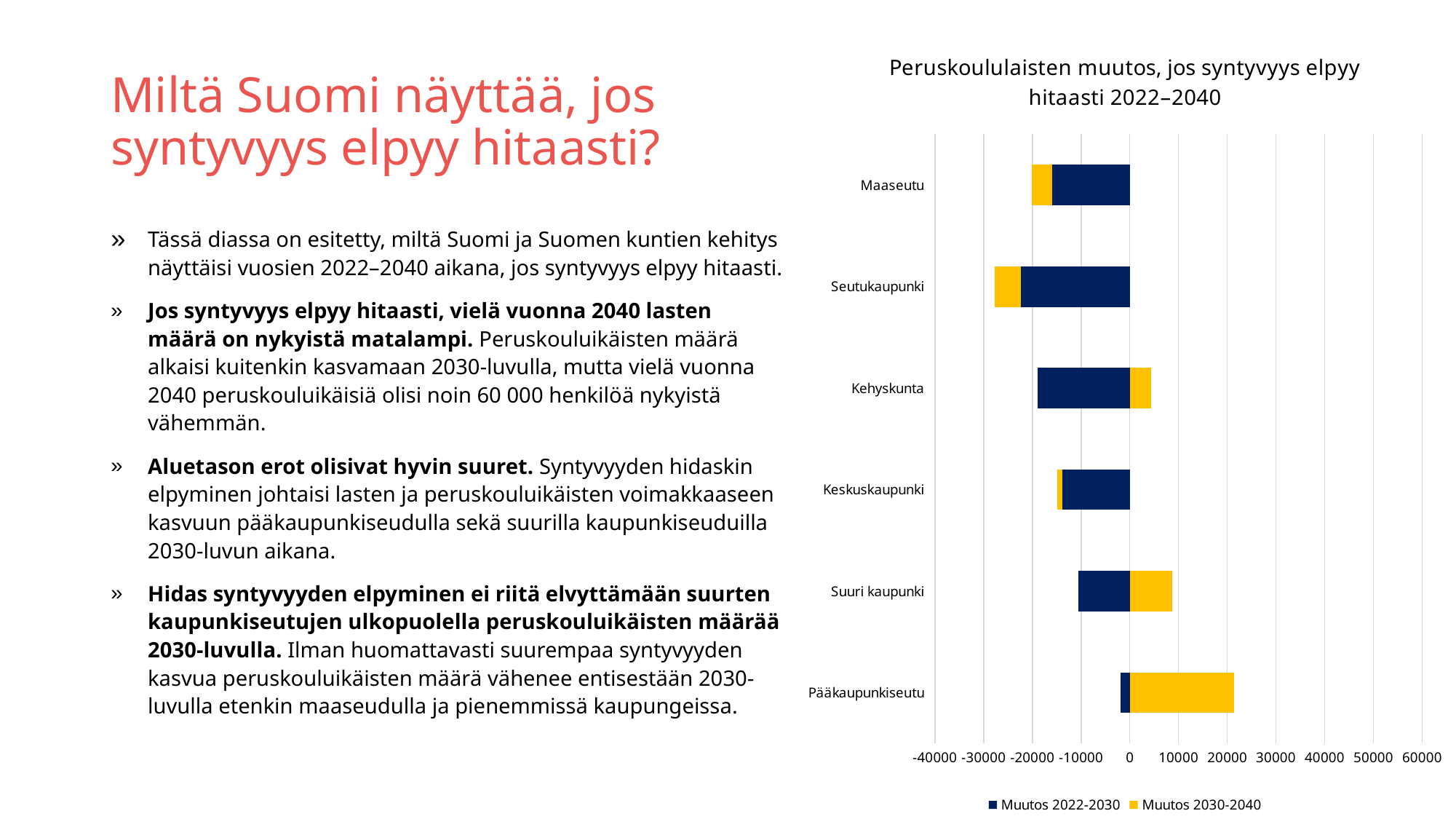
Which category has the largest positive value for Muutos 2030-2040? Pääkaupunkiseutu Is the value for Muutos 2030-2040 for Pääkaupunkiseutu greater or less than 10000? greater Is the value for Muutos 2022-2030 for Maaseutu greater or less than -10000? less What kind of chart is shown on the slide? Bar chart Which has the larger Muutos 2030-2040 value, Pääkaupunkiseutu or Suuri kaupunki? Pääkaupunkiseutu How many categories (area types) are shown on the chart? 6 What is the title of the chart? Peruskoululaisten muutos, jos syntyvyys elpyy hitaasti 2022–2040 Which category has the most negative value for Muutos 2022-2030? Seutukaupunki Which category has the smallest decline (value closest to zero) for Muutos 2022-2030? Pääkaupunkiseutu Is the value for Muutos 2030-2040 for Suuri kaupunki greater or less than 0? greater How many series does the chart legend list? 2 Which series is shown in yellow in the chart? Muutos 2030-2040